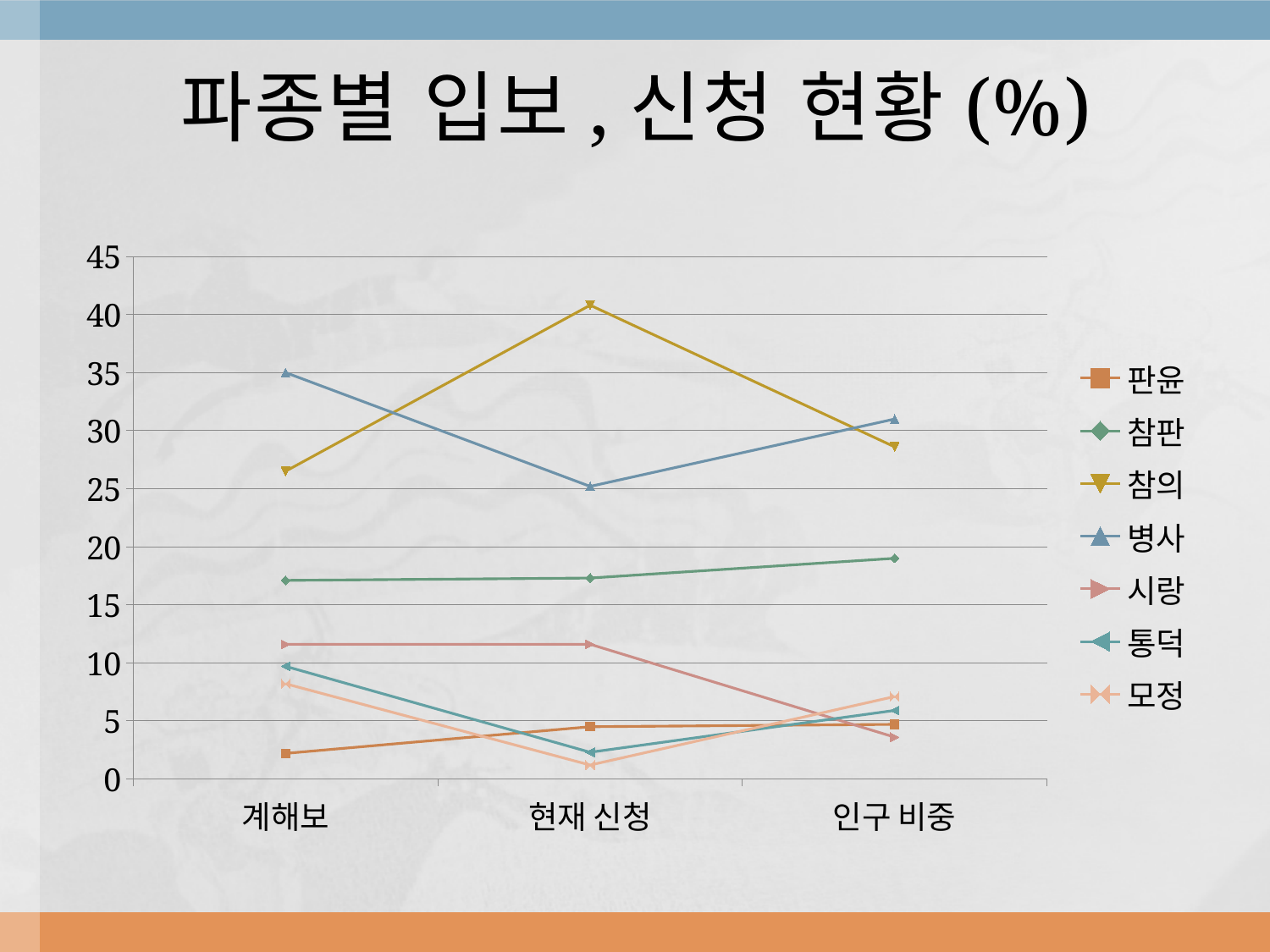
At 인구 비중, which is larger: 병사 or 참의? 병사 Is the value for 시랑 at 인구 비중 greater or less than 5? less What kind of chart is shown on the slide? line chart Is the value for 참의 at 현재 신청 greater or less than 35? greater Does the 판윤 series rise or fall from 계해보 to 인구 비중? rise Which series has the highest value at 현재 신청? 참의 Which series has the highest value at 계해보? 병사 How many series does the legend list? 7 How many categories are shown on the x axis? 3 What is the title of the chart? 파종별 입보 , 신청 현황 (%) Is the value for 병사 at 계해보 greater or less than 30? greater Which series has the lowest value at 계해보? 판윤